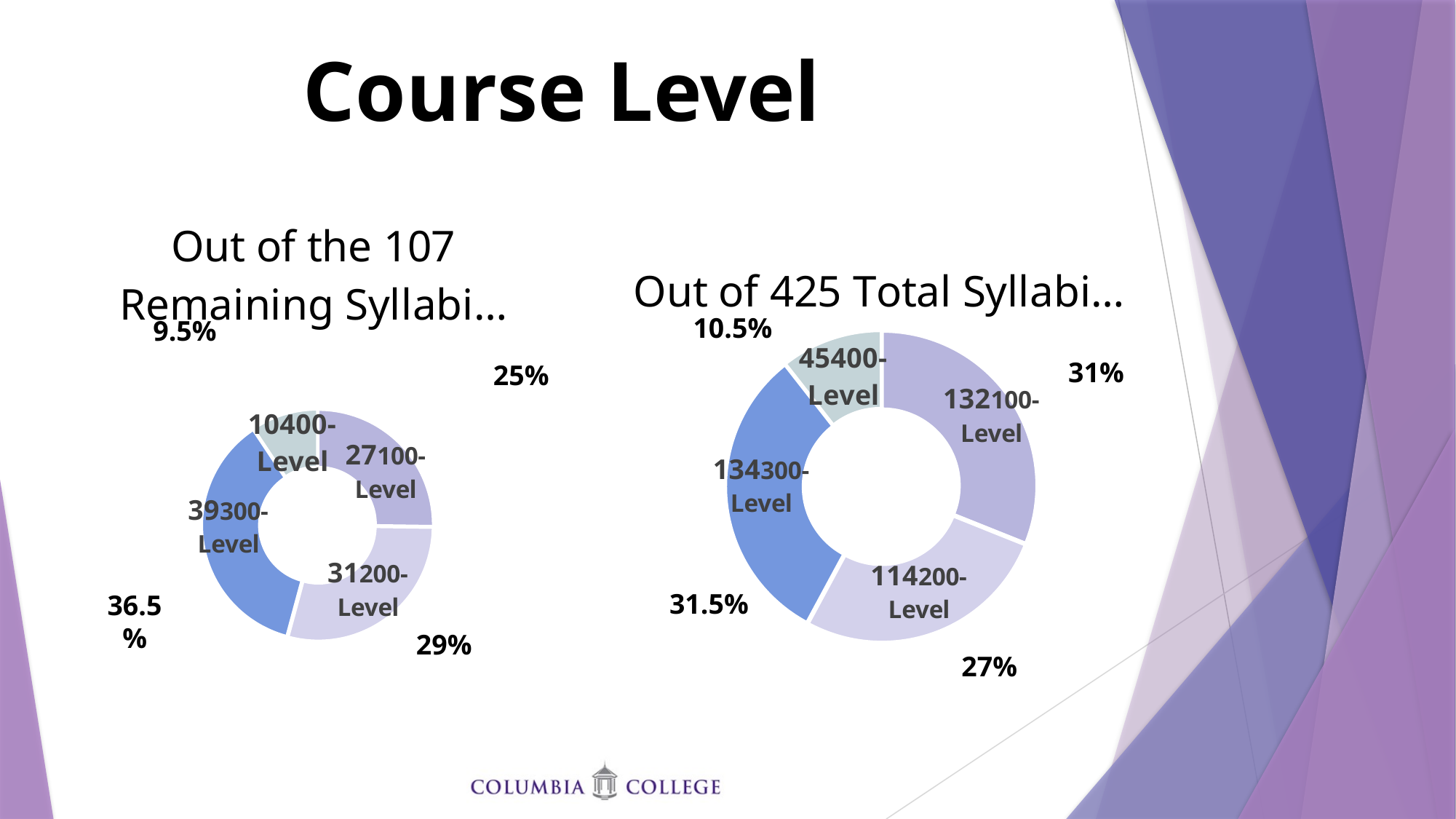
What type of chart is used on the slide for "Out of the 107 Remaining Syllabi..."? Doughnut (pie) chart In the "Out of the 107 Remaining Syllabi..." chart, how many slices are there? 4 In the "Out of 425 Total Syllabi..." chart, what percentage is shown for 400-Level courses? 10.5% In the "Out of 425 Total Syllabi..." chart, which course level has the smallest share? 400-Level In the "Out of the 107 Remaining Syllabi..." chart, what is the difference in percentage between 200-Level and 100-Level? 4% In the "Out of the 107 Remaining Syllabi..." chart, what percentage is shown for 300-Level courses? 36.5% In the "Out of the 107 Remaining Syllabi..." chart, which course level has the smallest share? 400-Level In the "Out of 425 Total Syllabi..." chart, what is the difference in syllabi count between 300-Level and 400-Level? 89 In the "Out of the 107 Remaining Syllabi..." chart, which course level has the largest share? 300-Level In the "Out of the 107 Remaining Syllabi..." chart, how many syllabi are 100-Level? 27 In the "Out of 425 Total Syllabi..." chart, which has more syllabi: 100-Level or 200-Level? 100-Level In the "Out of 425 Total Syllabi..." chart, how many syllabi are 200-Level? 114